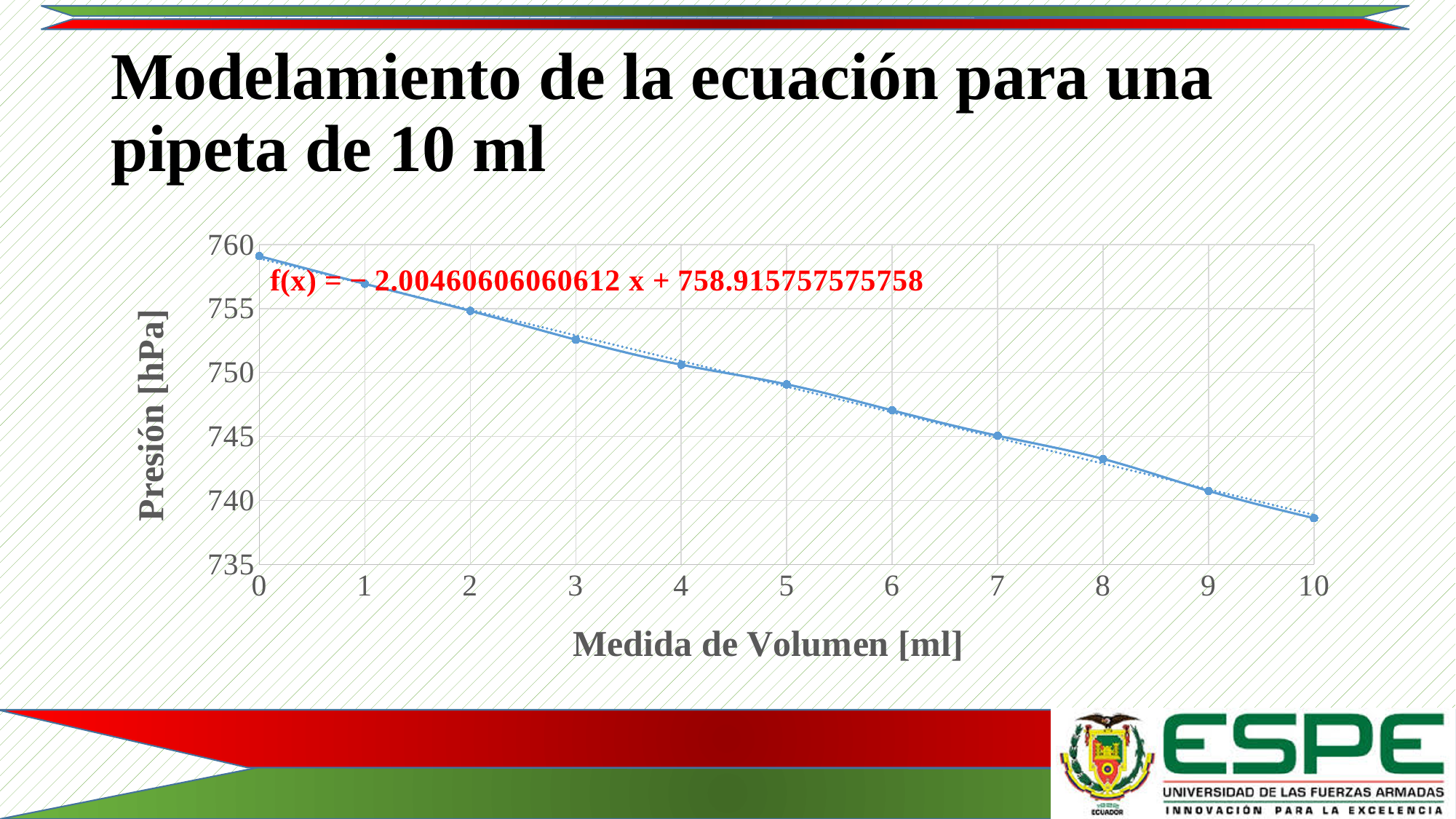
Is the pressure at a volume of 6 ml greater or less than 750 hPa? less Do the pressure values rise or fall as the volume increases along the x axis? fall How many data points are plotted on the chart? 11 What is the label of the y axis of the chart? Presión [hPa] At which volume measurement is the pressure highest? 0 Is the pressure at a volume of 8 ml greater or less than 740 hPa? greater Is the pressure at a volume of 3 ml greater or less than 750 hPa? greater Which has the higher pressure: a volume of 2 ml or a volume of 8 ml? 2 ml At which volume measurement is the pressure lowest? 10 What kind of chart is shown on the slide? line chart